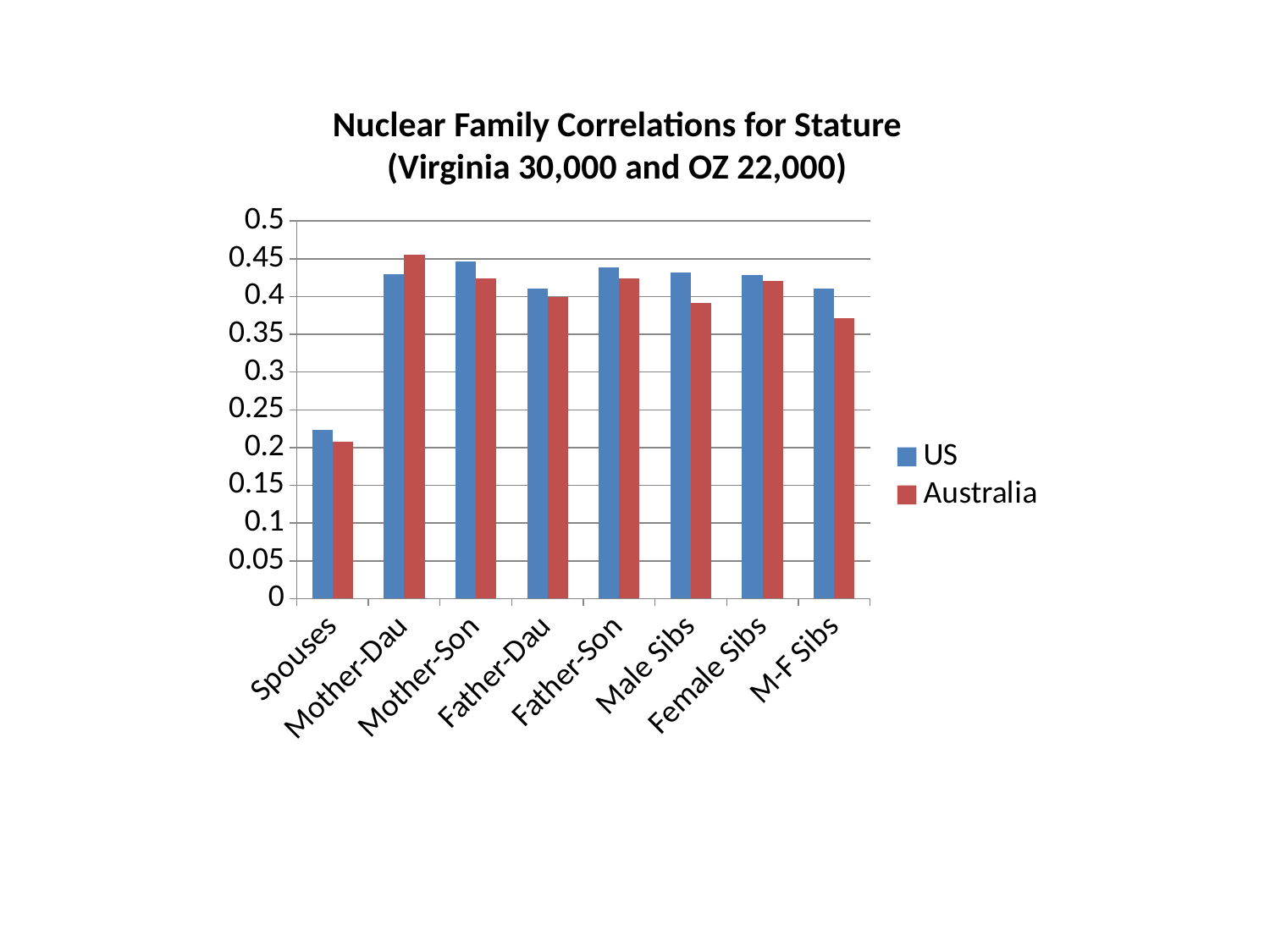
Is the US value for Spouses greater or less than 0.25? less How many series does the legend list? 2 For Male Sibs, which series has the larger value, US or Australia? US What is the title of the chart? Nuclear Family Correlations for Stature (Virginia 30,000 and OZ 22,000) Is the US value for Mother-Son greater or less than 0.4? greater For Mother-Dau, which series has the larger value, US or Australia? Australia Which category has the highest Australia correlation? Mother-Dau Which category has the lowest US correlation? Spouses What type of chart is shown on the slide? bar chart Is the Australia value for M-F Sibs greater or less than 0.4? less How many categories are shown on the x axis? 8